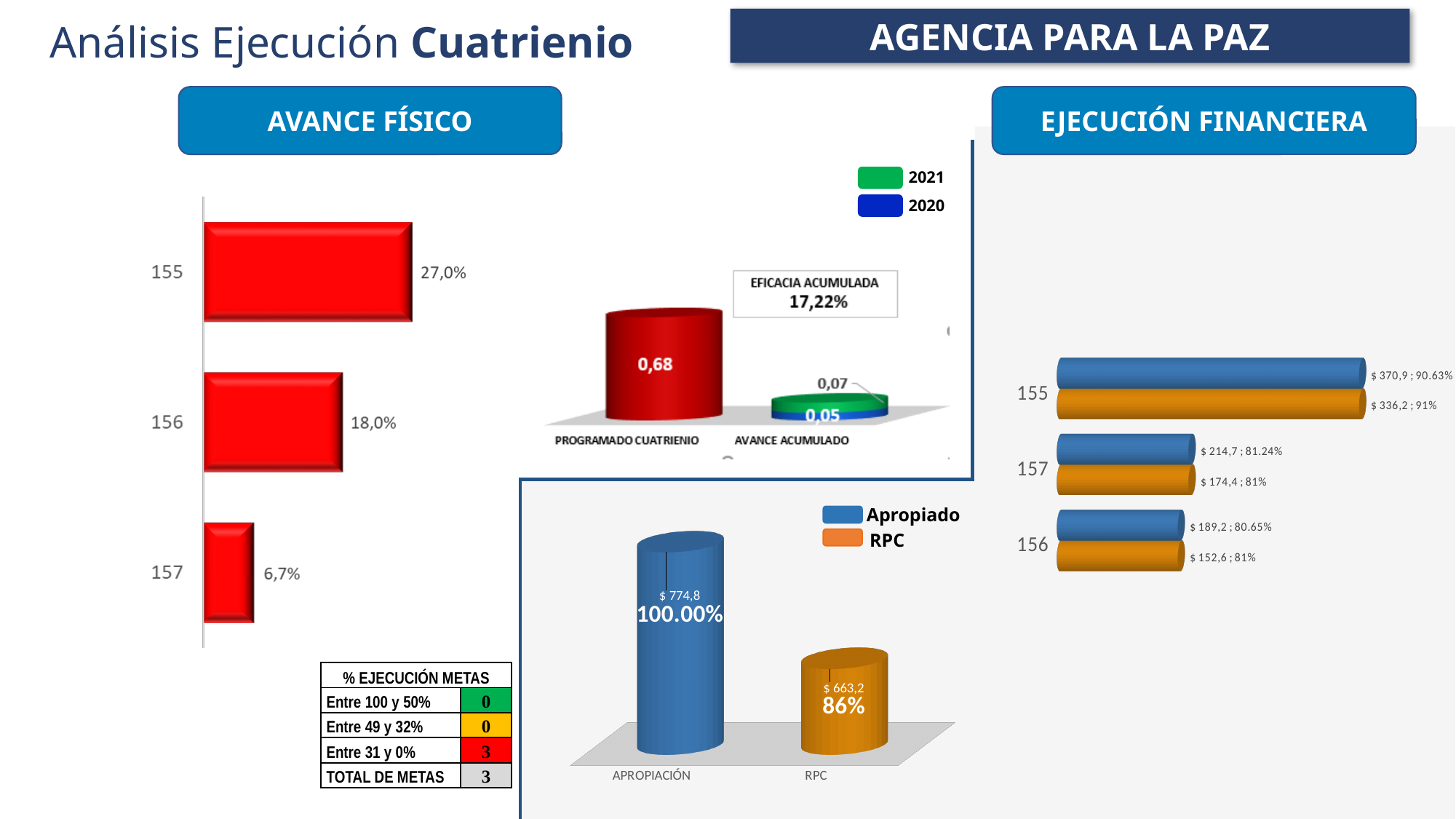
In the chart in the top middle with PROGRAMADO CUATRIENIO and AVANCE ACUMULADO, how many series does the legend list? 2 In the horizontal bar chart on the right under EJECUCIÓN FINANCIERA, what is the Apropiado value for category 157? $ 214,7 In the red horizontal bar chart on the left under AVANCE FÍSICO, which category has the lowest value? 157 In the horizontal bar chart on the right under EJECUCIÓN FINANCIERA, which category has the highest Apropiado value? 155 In the red horizontal bar chart on the left under AVANCE FÍSICO, what is the difference between the values for 155 and 156? 9,0% In the chart at the bottom middle with APROPIACIÓN and RPC, what is the value shown for RPC? $ 663,2 In the chart at the bottom middle with APROPIACIÓN and RPC, what percentage is shown for APROPIACIÓN? 100.00% In the red horizontal bar chart on the left under AVANCE FÍSICO, what is the value for category 157? 6,7% In the red horizontal bar chart on the left under AVANCE FÍSICO, what is the value for category 155? 27,0% In the chart in the top middle with PROGRAMADO CUATRIENIO and AVANCE ACUMULADO, what is the value for PROGRAMADO CUATRIENIO? 0,68 In the chart in the top middle with PROGRAMADO CUATRIENIO and AVANCE ACUMULADO, what is the 2021 value for AVANCE ACUMULADO? 0,07 In the red horizontal bar chart on the left under AVANCE FÍSICO, how many categories are shown? 3